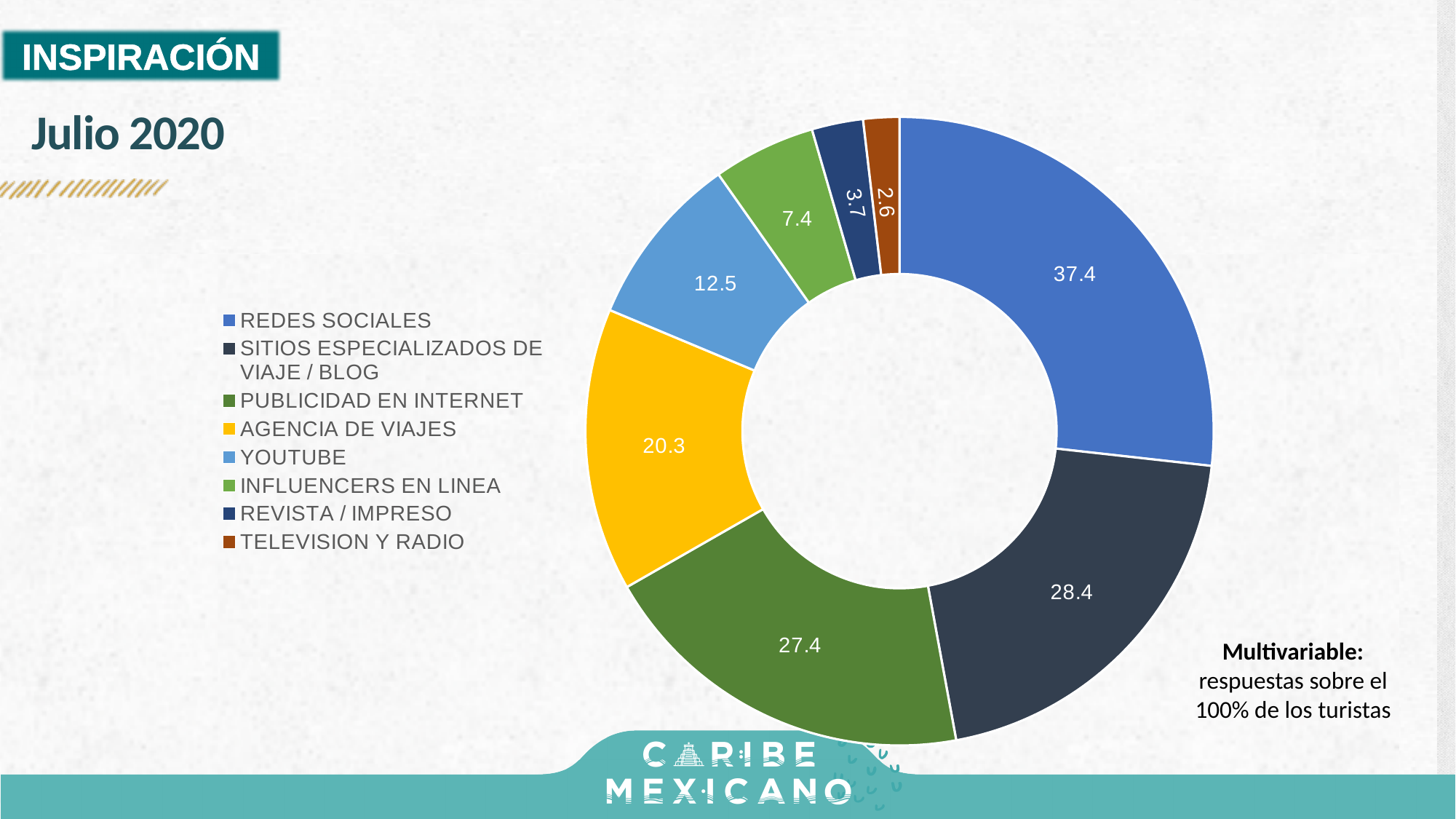
Which is larger, the value for PUBLICIDAD EN INTERNET or the value for AGENCIA DE VIAJES? PUBLICIDAD EN INTERNET Which category has the highest value? REDES SOCIALES How many categories does the chart show? 8 What kind of chart is shown on the slide? Doughnut chart What is the difference between the values for REDES SOCIALES and SITIOS ESPECIALIZADOS DE VIAJE / BLOG? 9.0 What is the value for REDES SOCIALES? 37.4 What is the difference between the values for YOUTUBE and INFLUENCERS EN LINEA? 5.1 What is the value for YOUTUBE? 12.5 What is the value for REVISTA / IMPRESO? 3.7 What is the value for AGENCIA DE VIAJES? 20.3 Which category has the lowest value? TELEVISION Y RADIO What colour is the segment for AGENCIA DE VIAJES? Yellow